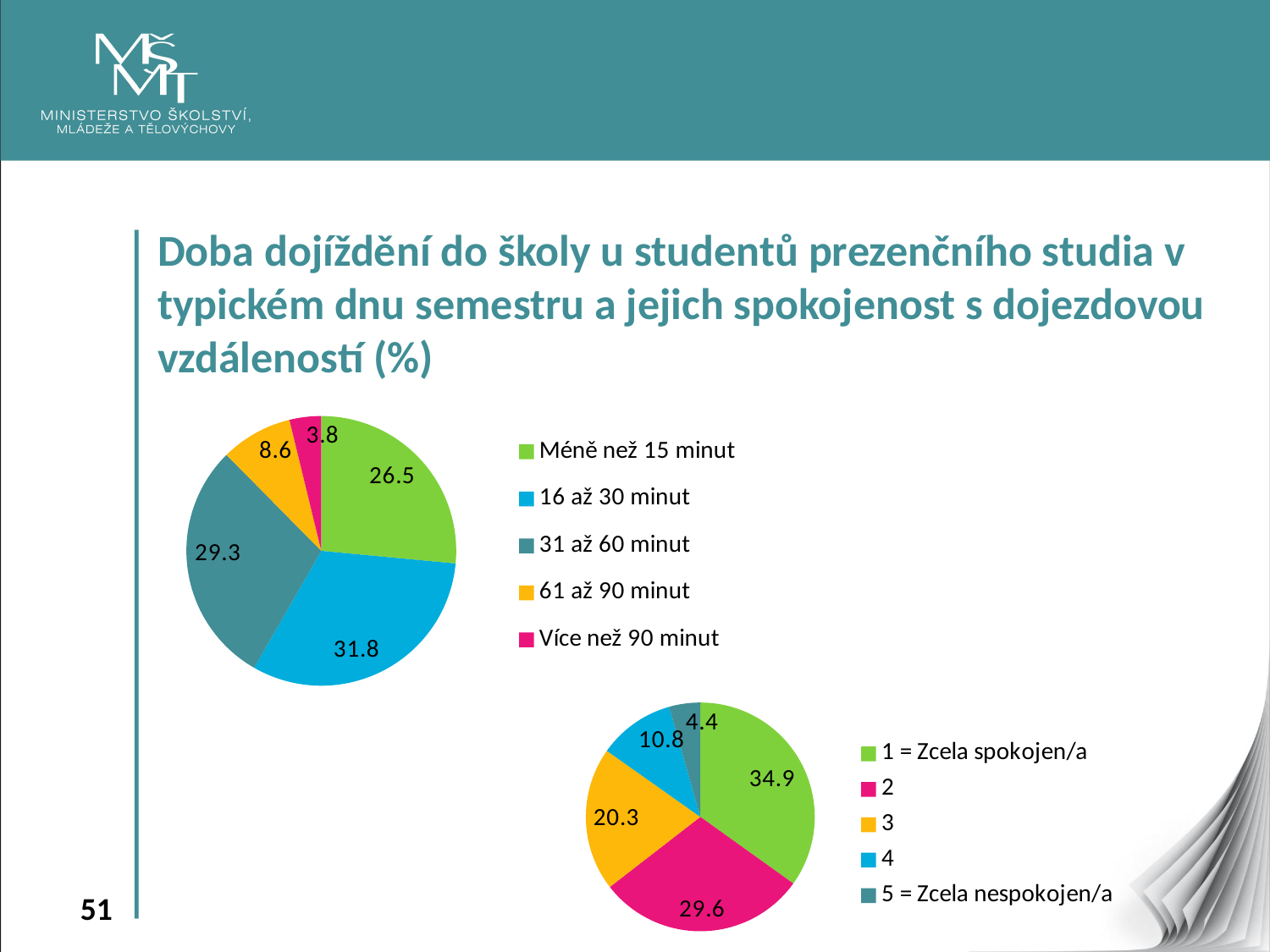
In the upper-left pie chart, which category has the largest share? 16 až 30 minut In the upper-left pie chart, how many categories does the legend list? 5 In the upper-left pie chart, what is the difference between the values for '31 až 60 minut' and '61 až 90 minut'? 20.7 In the upper-left pie chart, what is the value for '16 až 30 minut'? 31.8 In the upper-left pie chart, which category has the smallest share? Více než 90 minut In the lower-right pie chart, which is larger, the value for '3' or the value for '4'? 3 In the lower-right pie chart, what is the value for '5 = Zcela nespokojen/a'? 4.4 In the lower-right pie chart, which category has the largest share? 1 = Zcela spokojen/a In the lower-right pie chart, what is the difference between the values for '2' and '3'? 9.3 In the lower-right pie chart, what is the value for '1 = Zcela spokojen/a'? 34.9 What type of chart is the lower-right chart? Pie chart In the upper-left pie chart, what is the value for 'Více než 90 minut'? 3.8